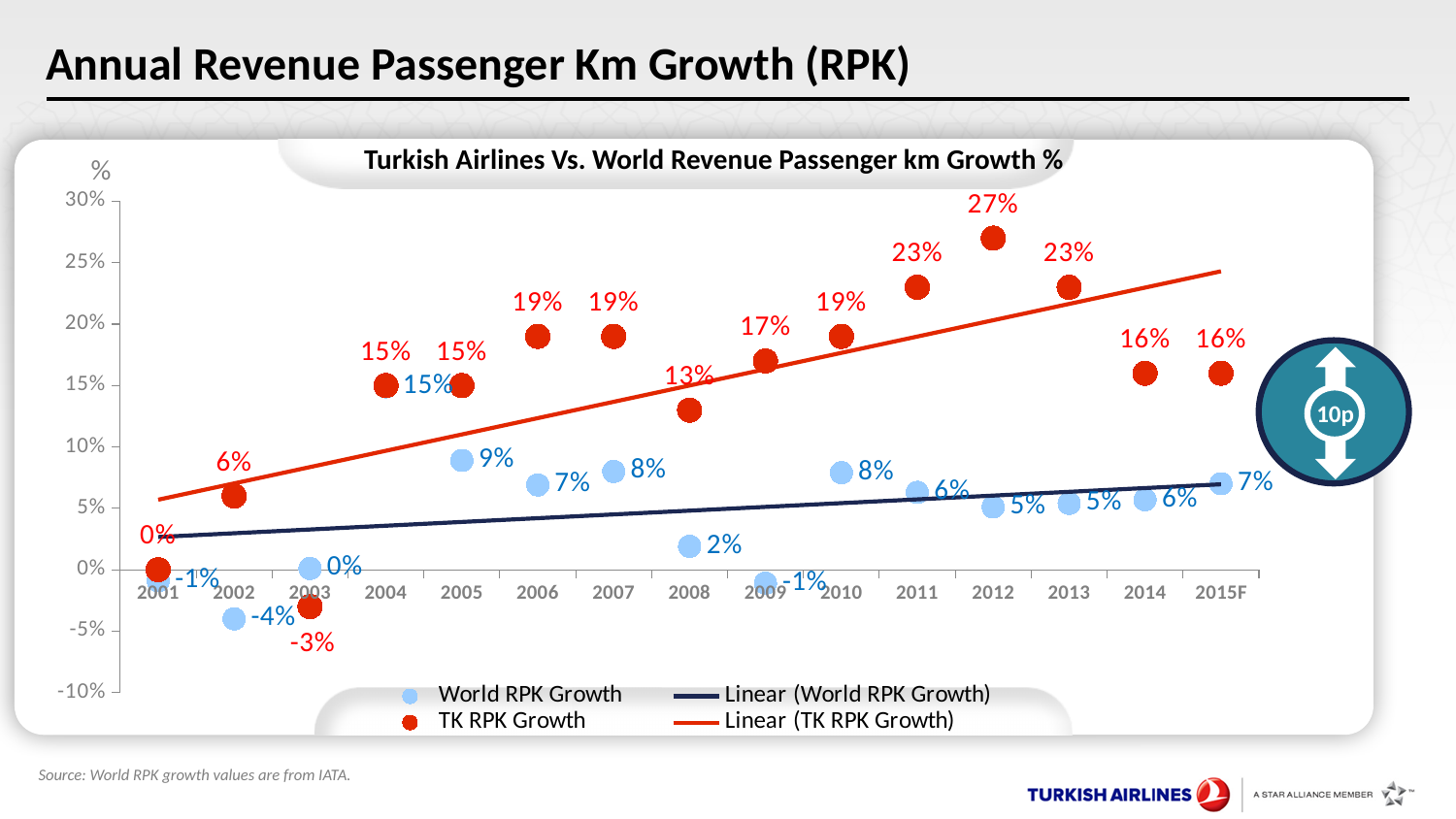
What is the TK RPK Growth value for 2012? 27% In which year is TK RPK Growth lowest? 2003 What is the World RPK Growth value for 2015F? 7% Does the Linear (TK RPK Growth) trend line rise or fall from 2001 to 2015F? Rises What is the World RPK Growth value for 2002? -4% What is the title of the chart? Turkish Airlines Vs. World Revenue Passenger km Growth % How many years are shown on the x axis? 15 What is the difference between TK RPK Growth and World RPK Growth in 2011? 17 percentage points How many entries does the legend list? 4 In 2008, which is larger: TK RPK Growth or World RPK Growth? TK RPK Growth In which year is World RPK Growth lowest? 2002 In which year is TK RPK Growth highest? 2012